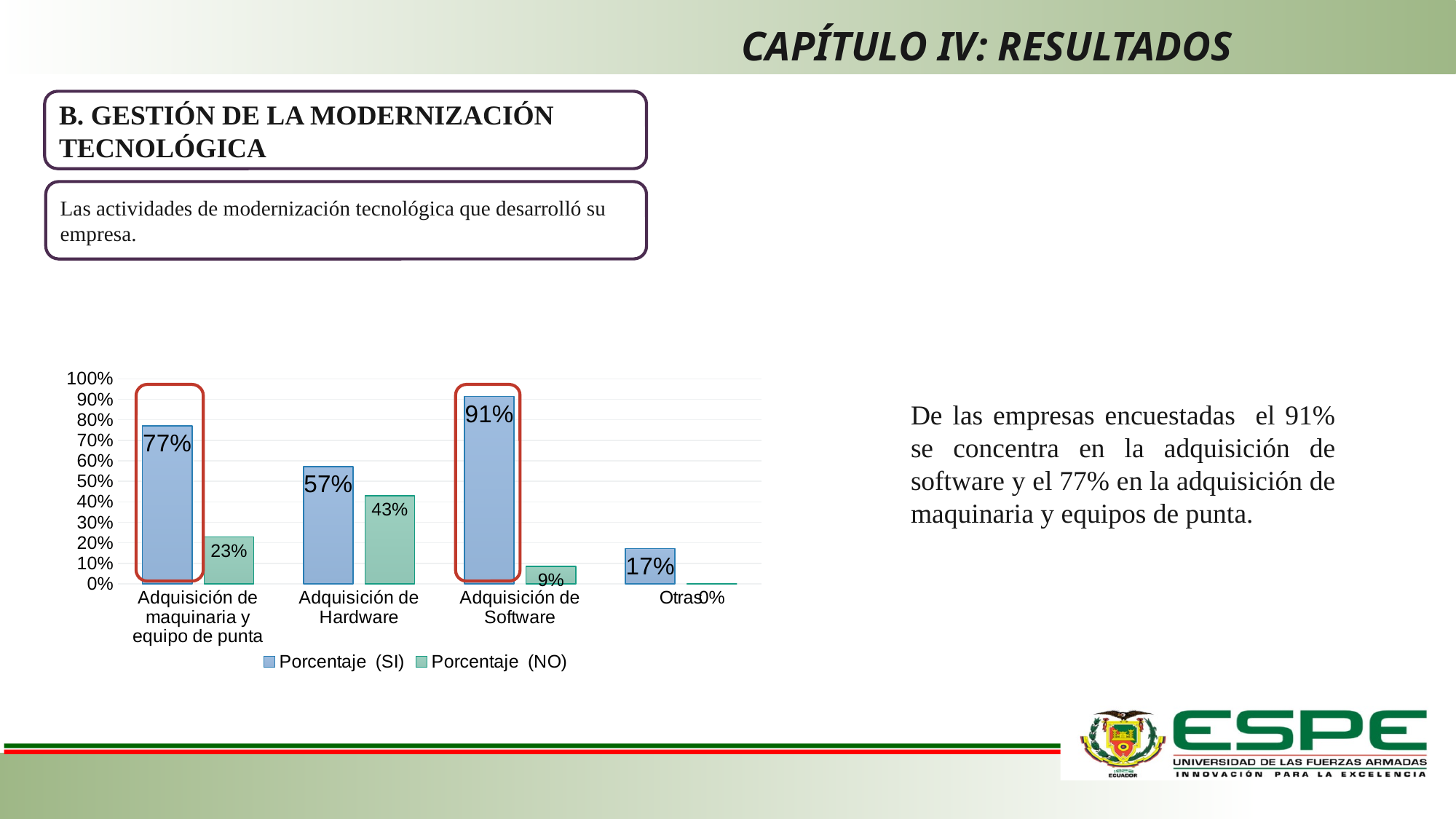
What is the difference between the Porcentaje (SI) values for Adquisición de Software and Adquisición de maquinaria y equipo de punta? 14% Which category has the highest Porcentaje (SI) value? Adquisición de Software What kind of chart is shown on the slide? Bar chart What is the Porcentaje (NO) value for Adquisición de maquinaria y equipo de punta? 23% What colour are the Porcentaje (NO) bars in the chart? Green Which is larger for Adquisición de Hardware: Porcentaje (SI) or Porcentaje (NO)? Porcentaje (SI) What is the Porcentaje (SI) value for Otras? 17% Which category has the lowest Porcentaje (NO) value? Otras How many series does the chart legend list? 2 What is the Porcentaje (NO) value for Adquisición de Hardware? 43% How many categories are shown on the x axis of the chart? 4 What is the Porcentaje (SI) value for Adquisición de Software? 91%